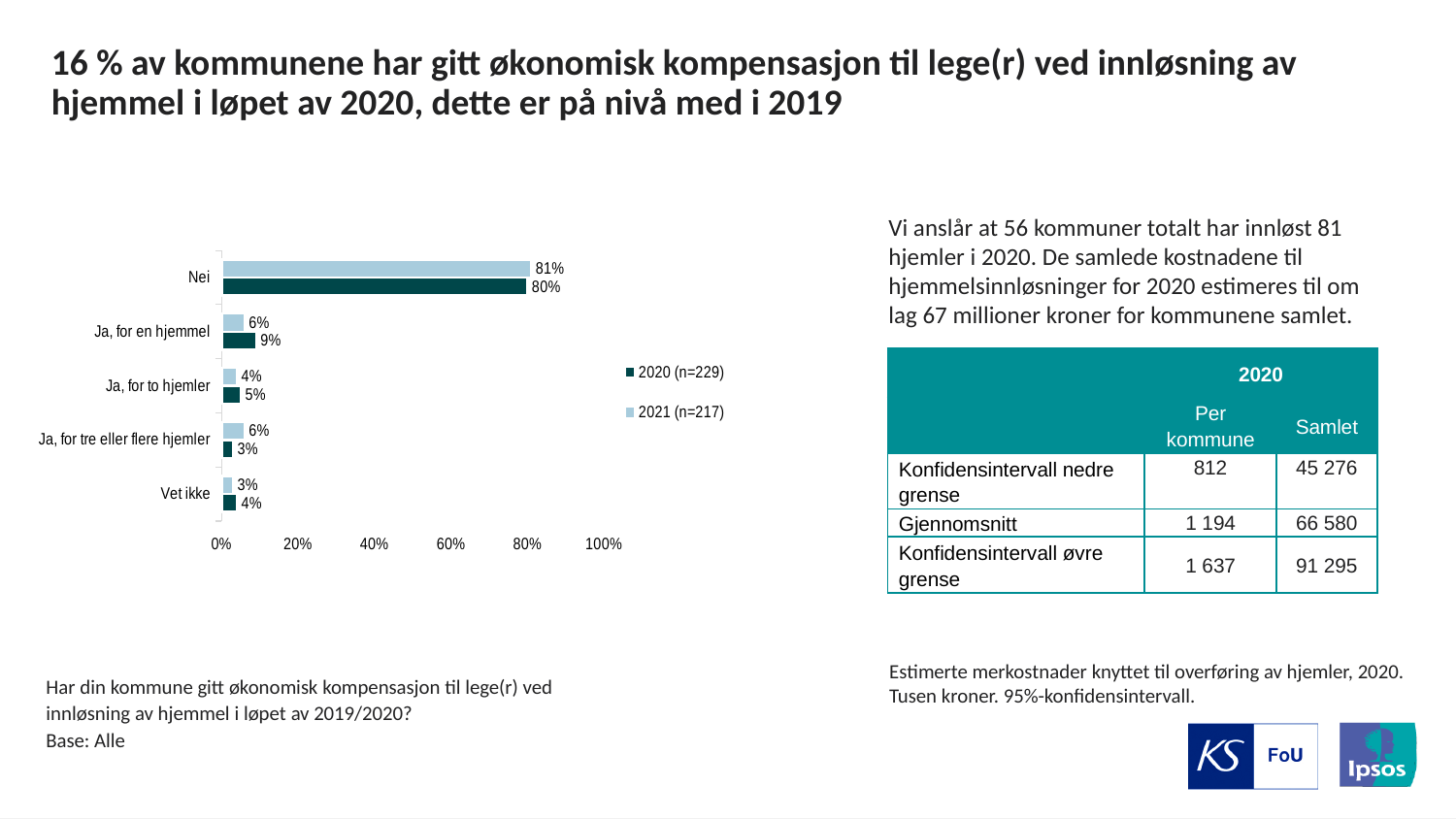
Which category has the lowest value in the 2020 (n=229) series? Ja, for tre eller flere hjemler How many categories are shown on the chart? 5 What is the value for "Ja, for en hjemmel" in the 2020 (n=229) series? 9% What is the value for "Nei" in the 2021 (n=217) series? 81% For "Ja, for to hjemler", which series has the larger value, 2020 (n=229) or 2021 (n=217)? 2020 (n=229) What is the value for "Vet ikke" in the 2020 (n=229) series? 4% How many series does the legend list? 2 What is the value for "Nei" in the 2020 (n=229) series? 80% Which category has the highest value in the 2021 (n=217) series? Nei What is the value for "Ja, for tre eller flere hjemler" in the 2021 (n=217) series? 6% What kind of chart is shown on the slide? Bar chart What is the difference between the 2020 (n=229) and 2021 (n=217) values for "Ja, for en hjemmel"? 3 percentage points